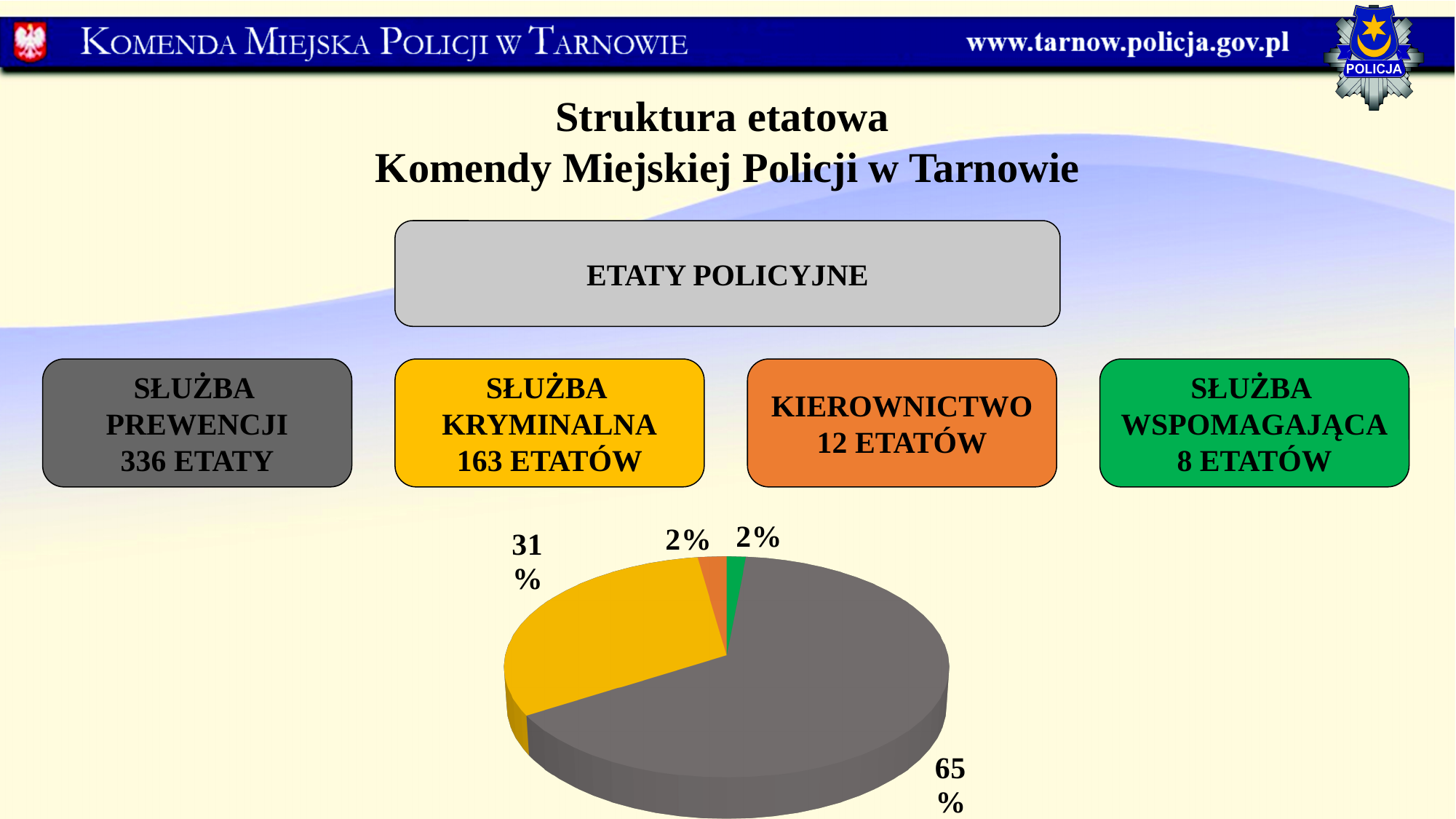
What share of the pie does the grey slice (Służba Prewencji) represent? 65% What colour is the slice representing Służba Kryminalna in the pie chart? yellow What share of the pie does the orange slice (Kierownictwo) represent? 2% Which slice of the pie chart is the largest? grey (Służba Prewencji), 65% How many slices does the pie chart have? 4 What kind of chart is shown on the slide? pie chart How many police posts (etaty) does the Służba Prewencji box show? 336 Which is larger in the pie chart: the grey slice or the yellow slice? grey slice How many police posts (etaty) does the Kierownictwo box show? 12 What share of the pie does the green slice (Służba Wspomagająca) represent? 2% What is the difference in percentage points between the grey slice (65%) and the yellow slice (31%)? 34